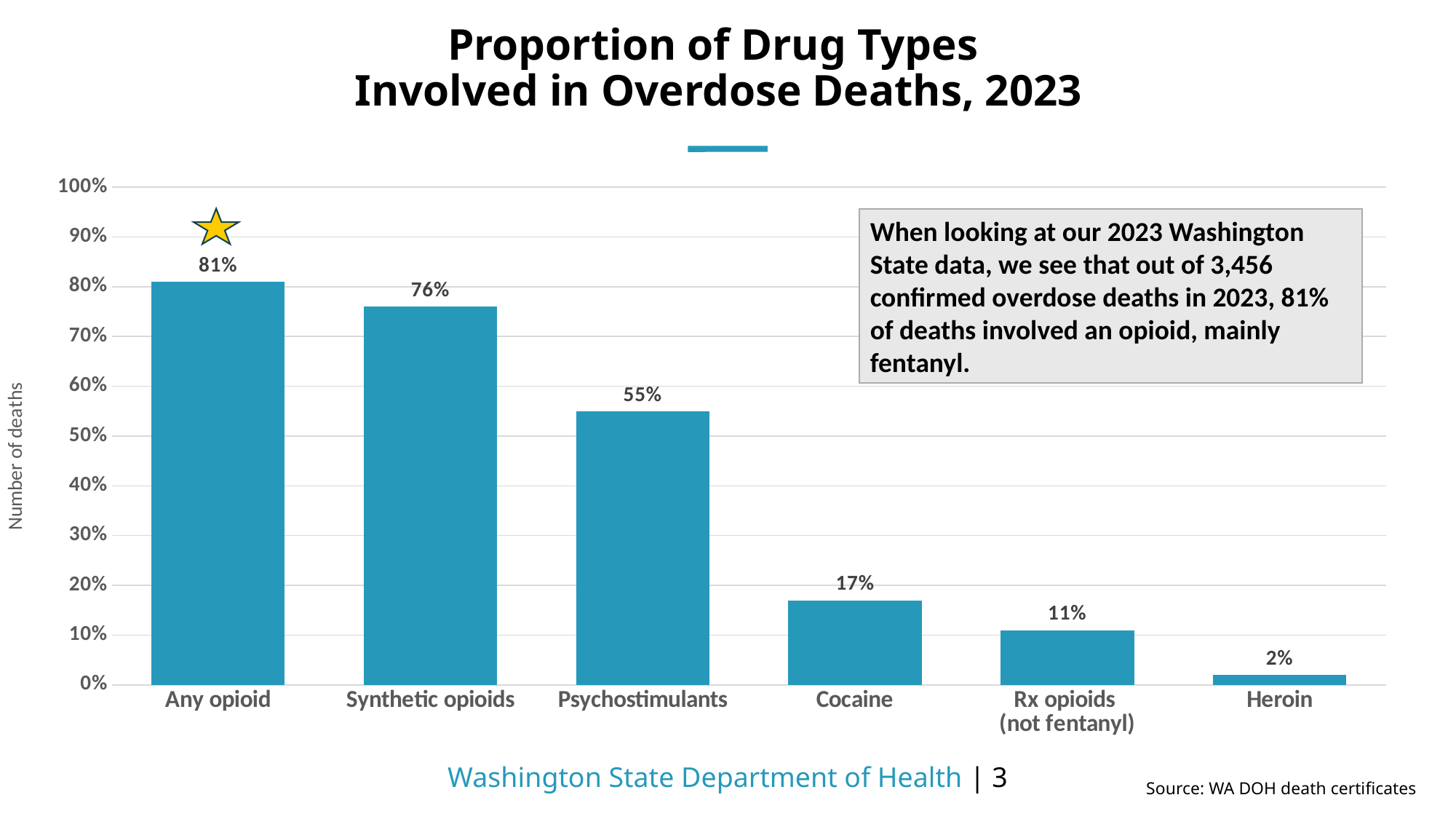
Which is larger, the value for Cocaine or the value for Rx opioids (not fentanyl)? Cocaine What is the value for Psychostimulants? 55% Which category has the lowest value? Heroin What is the value for Rx opioids (not fentanyl)? 11% What is the difference between the values for Cocaine and Heroin? 15% What is the title of the chart? Proportion of Drug Types Involved in Overdose Deaths, 2023 What is the value for Synthetic opioids? 76% Which category has the highest value? Any opioid What is the difference between the values for Any opioid and Synthetic opioids? 5% What kind of chart is shown on the slide? Bar chart What is the value for Any opioid? 81% How many categories are shown on the chart? 6